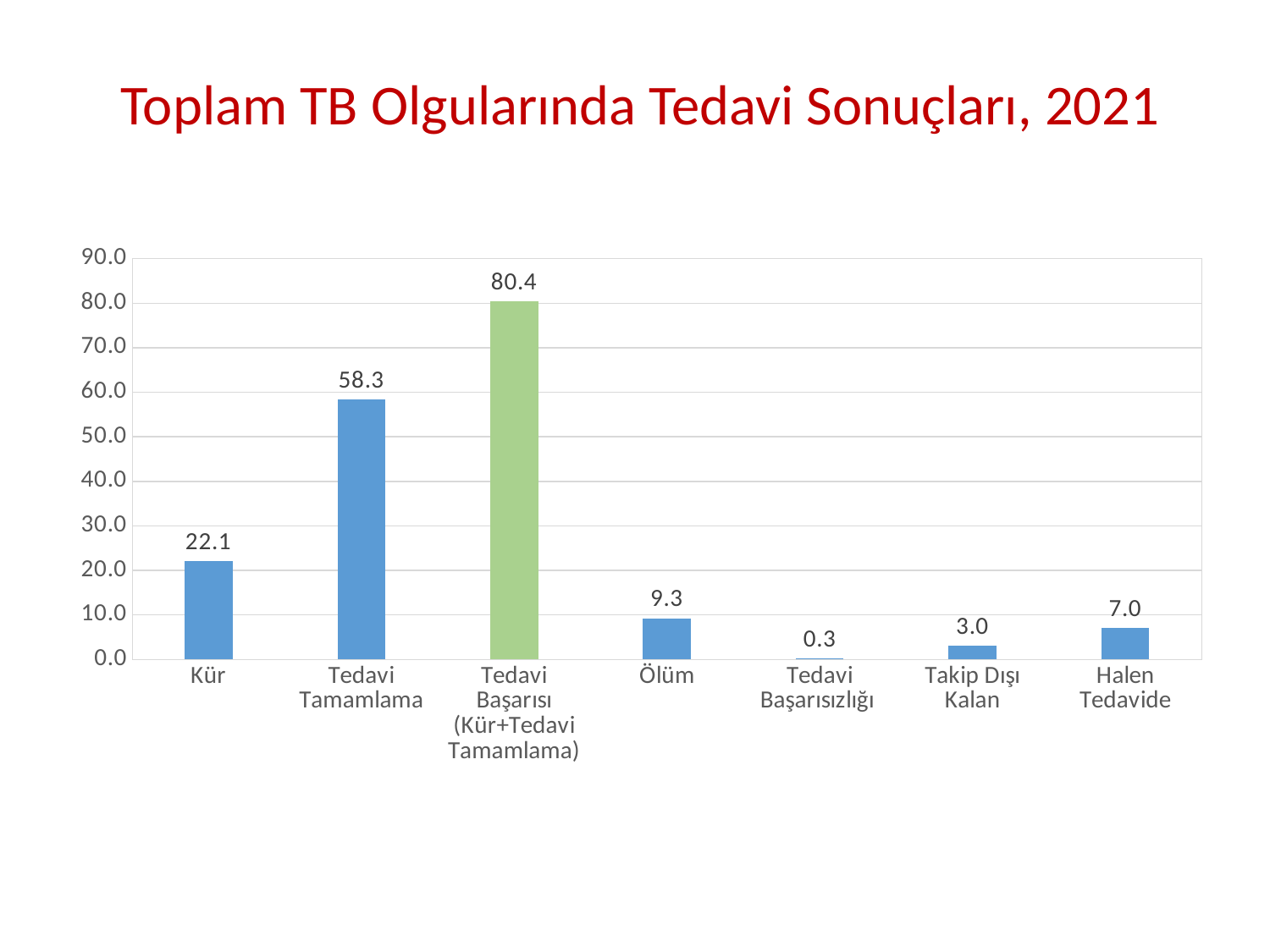
What is the title of the chart? Toplam TB Olgularında Tedavi Sonuçları, 2021 Which is larger, the value for Ölüm or the value for Halen Tedavide? Ölüm What is the value for Tedavi Tamamlama? 58.3 What is the value for Takip Dışı Kalan? 3.0 Which category has the highest value? Tedavi Başarısı (Kür+Tedavi Tamamlama) What is the value for Ölüm? 9.3 Which category has the lowest value? Tedavi Başarısızlığı What kind of chart is shown on the slide? Bar chart Which bar is coloured green rather than blue? Tedavi Başarısı (Kür+Tedavi Tamamlama) What is the value for Kür? 22.1 What is the difference between the values for Tedavi Tamamlama and Kür? 36.2 How many categories are shown on the x axis? 7